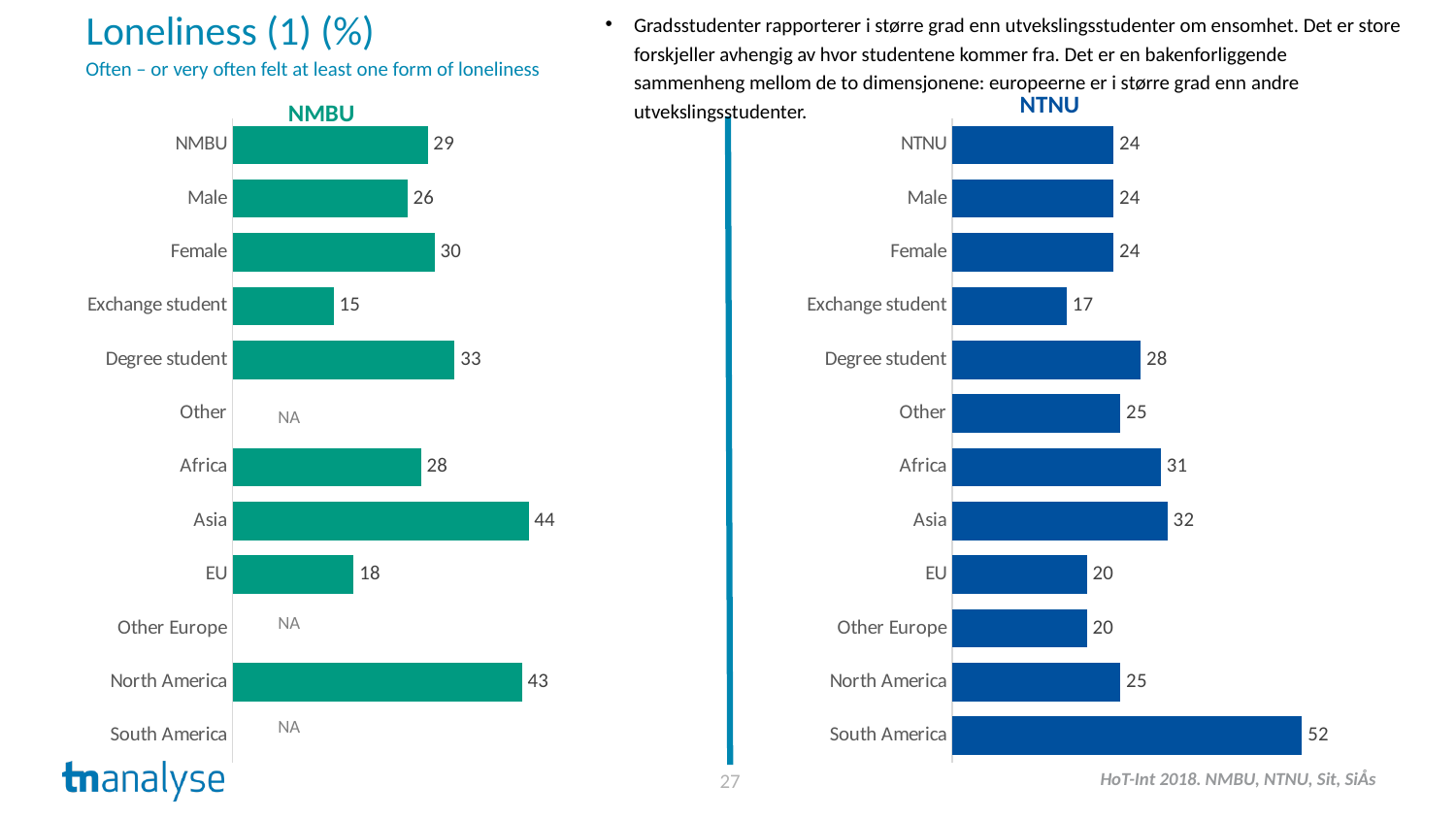
In the NMBU chart, how many categories are marked NA? 3 In the NMBU chart, what is the value for Exchange student? 15 In the NTNU chart, which category has the lowest value? Exchange student In the NTNU chart, what is the difference between the values for South America and Asia? 20 In the NMBU chart, which category has the highest value? Asia What is the title of the chart on the left side of the slide? NMBU In the NTNU chart, what is the value for Degree student? 28 In the NMBU chart, what is the value for Asia? 44 In the NTNU chart, which is larger, the value for Africa or the value for EU? Africa In the NTNU chart, what is the value for South America? 52 What kind of chart is the NTNU chart? Bar chart In the NMBU chart, what is the difference between the values for Female and Male? 4